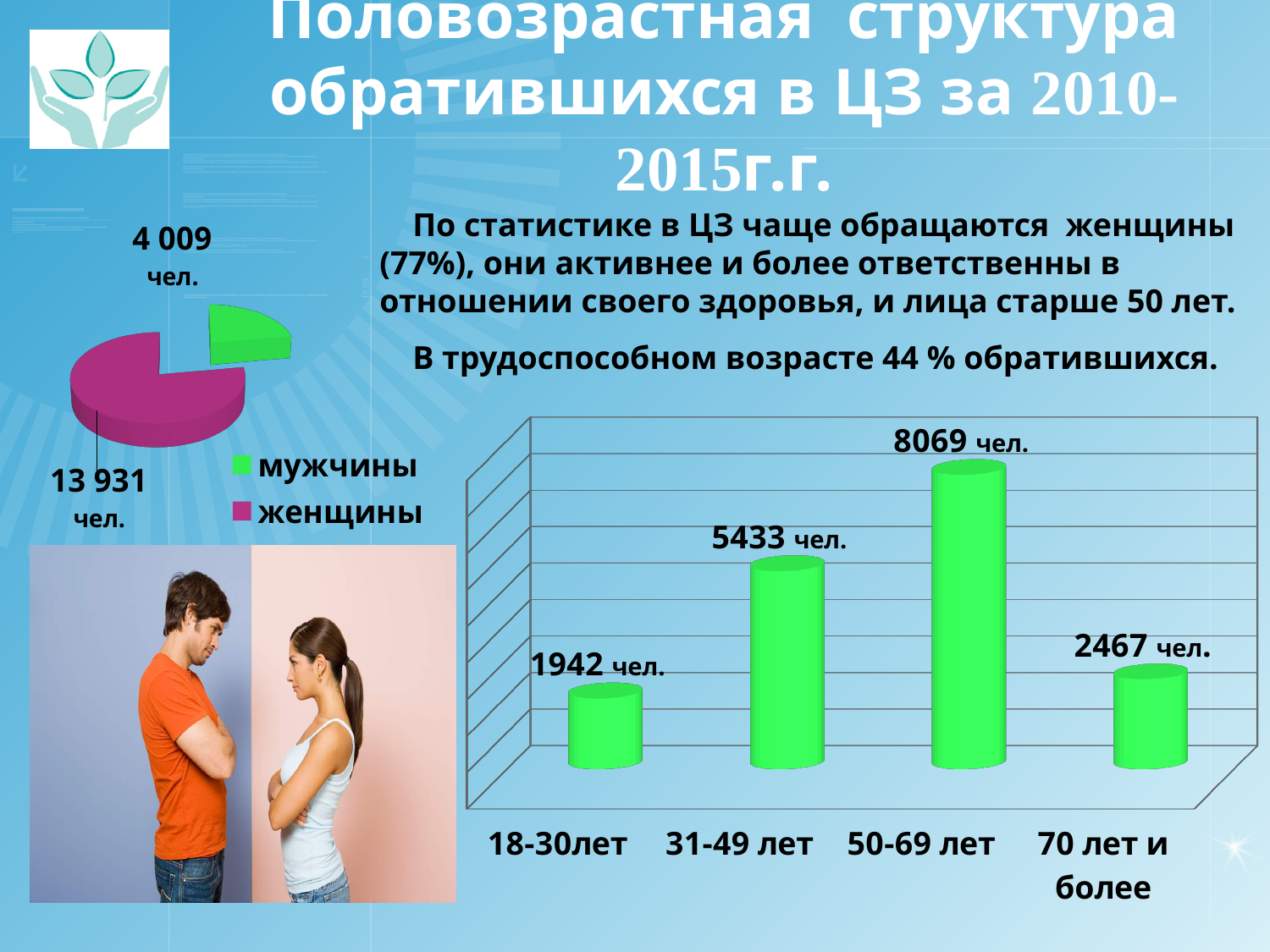
In the bar chart on the right, what is the value for the 70 лет и более age group? 2467 чел. In the pie chart on the left, how many people are shown for мужчины? 4 009 чел. In the bar chart on the right, what is the value for the 31-49 лет age group? 5433 чел. In the bar chart on the right, which age group has the lowest value? 18-30лет In the pie chart on the left, what is the difference between the number of женщины and the number of мужчины? 9 922 чел. In the bar chart on the right, what is the difference between the values for 50-69 лет and 31-49 лет? 2636 чел. In the bar chart on the right, which age group has the highest value? 50-69 лет In the pie chart on the left, which group is larger, мужчины or женщины? женщины In the pie chart on the left, what colour is the slice for женщины? Magenta (purple-pink) How many entries does the legend of the pie chart on the left list? 2 In the pie chart on the left, how many people are shown for женщины? 13 931 чел. How many age groups are shown in the bar chart on the right? 4